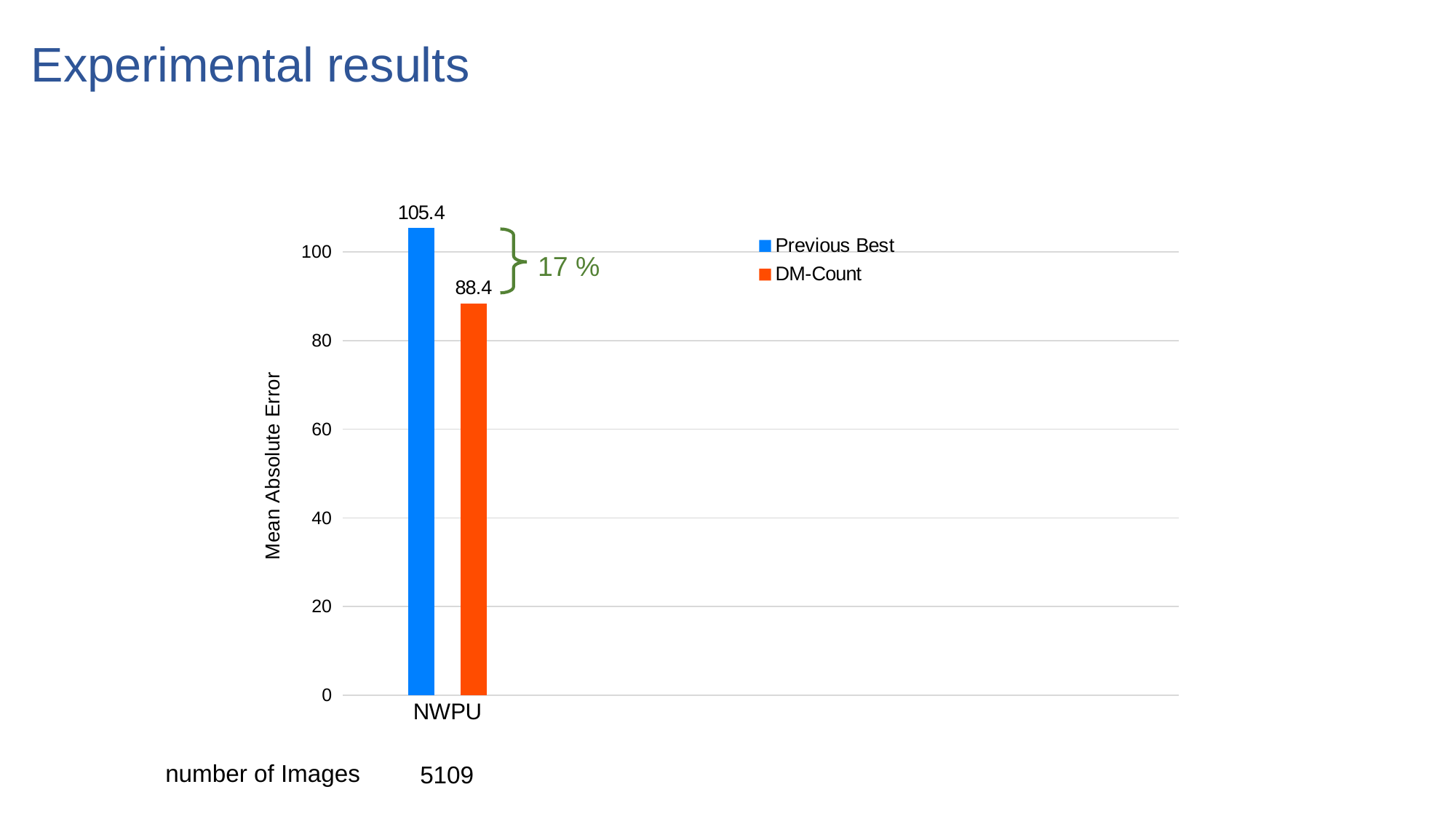
Is the value for DM-Count on NWPU greater or less than 100? less Which series has the higher Mean Absolute Error on NWPU? Previous Best What is the Mean Absolute Error for Previous Best on NWPU? 105.4 What is the Mean Absolute Error for DM-Count on NWPU? 88.4 What kind of chart is shown on the slide? bar chart What is the label of the y axis of the chart? Mean Absolute Error What is the difference in Mean Absolute Error between Previous Best and DM-Count on NWPU? 17 Is the value for Previous Best on NWPU greater or less than 100? greater Which series has the lower Mean Absolute Error on NWPU? DM-Count How many categories are shown on the x axis of the chart? 1 Is the Mean Absolute Error for Previous Best on NWPU larger or smaller than that for DM-Count? larger How many series does the legend list? 2